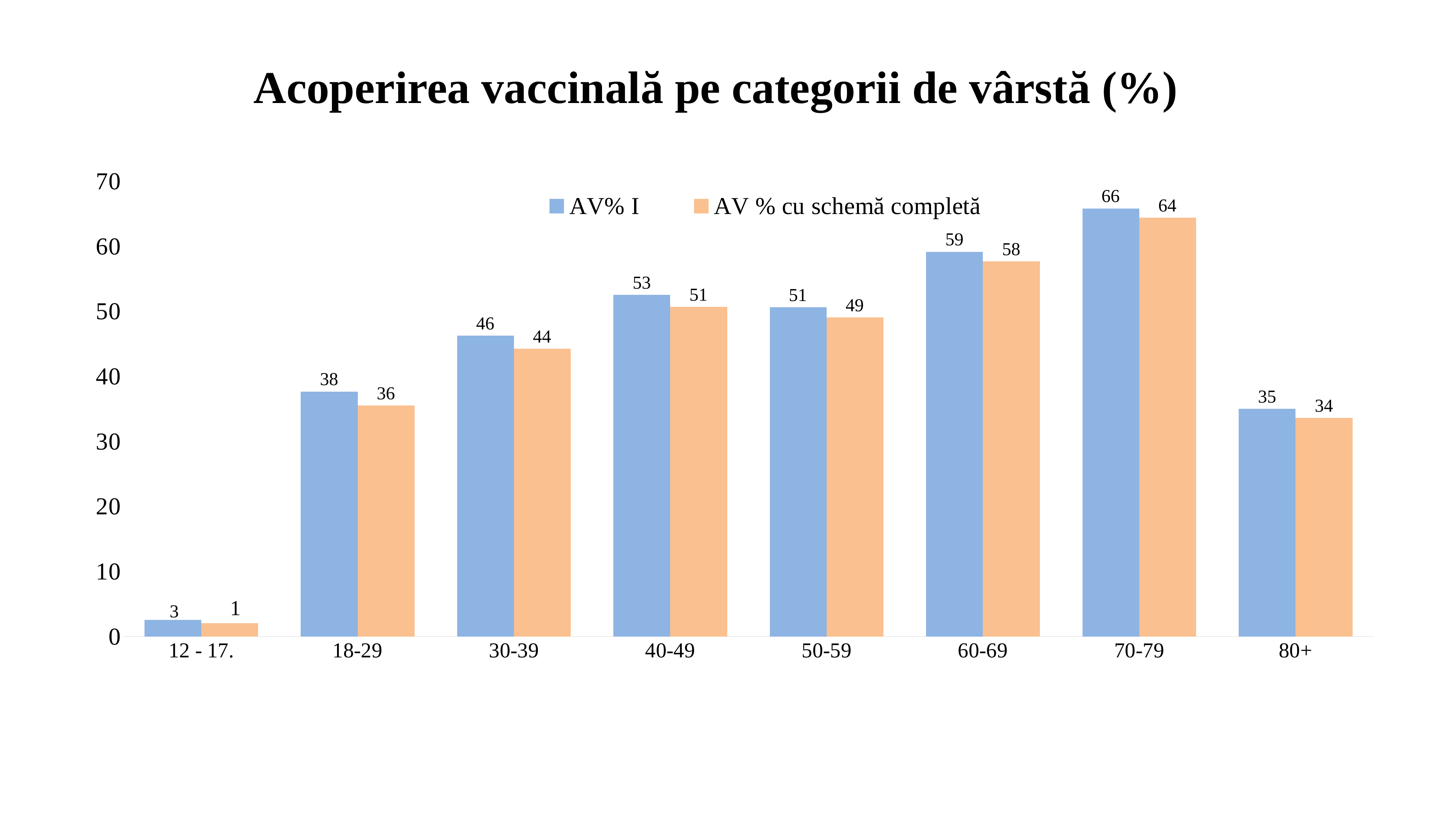
How many age groups are shown on the x axis? 8 Which is larger for the 80+ age group: AV% I or AV % cu schemă completă? AV% I What is the difference between AV% I and AV % cu schemă completă for the 60-69 age group? 1 Is the AV% I value for the 30-39 age group greater or less than 40? greater What is the title of the chart? Acoperirea vaccinală pe categorii de vârstă (%) What kind of chart is shown on the slide? Bar chart Which age group has the lowest AV % cu schemă completă value? 12 - 17. What is the AV% I value for the 40-49 age group? 53 How many series does the legend list? 2 What is the AV % cu schemă completă value for the 18-29 age group? 36 What colour are the AV % cu schemă completă bars? Orange Which age group has the highest AV% I value? 70-79